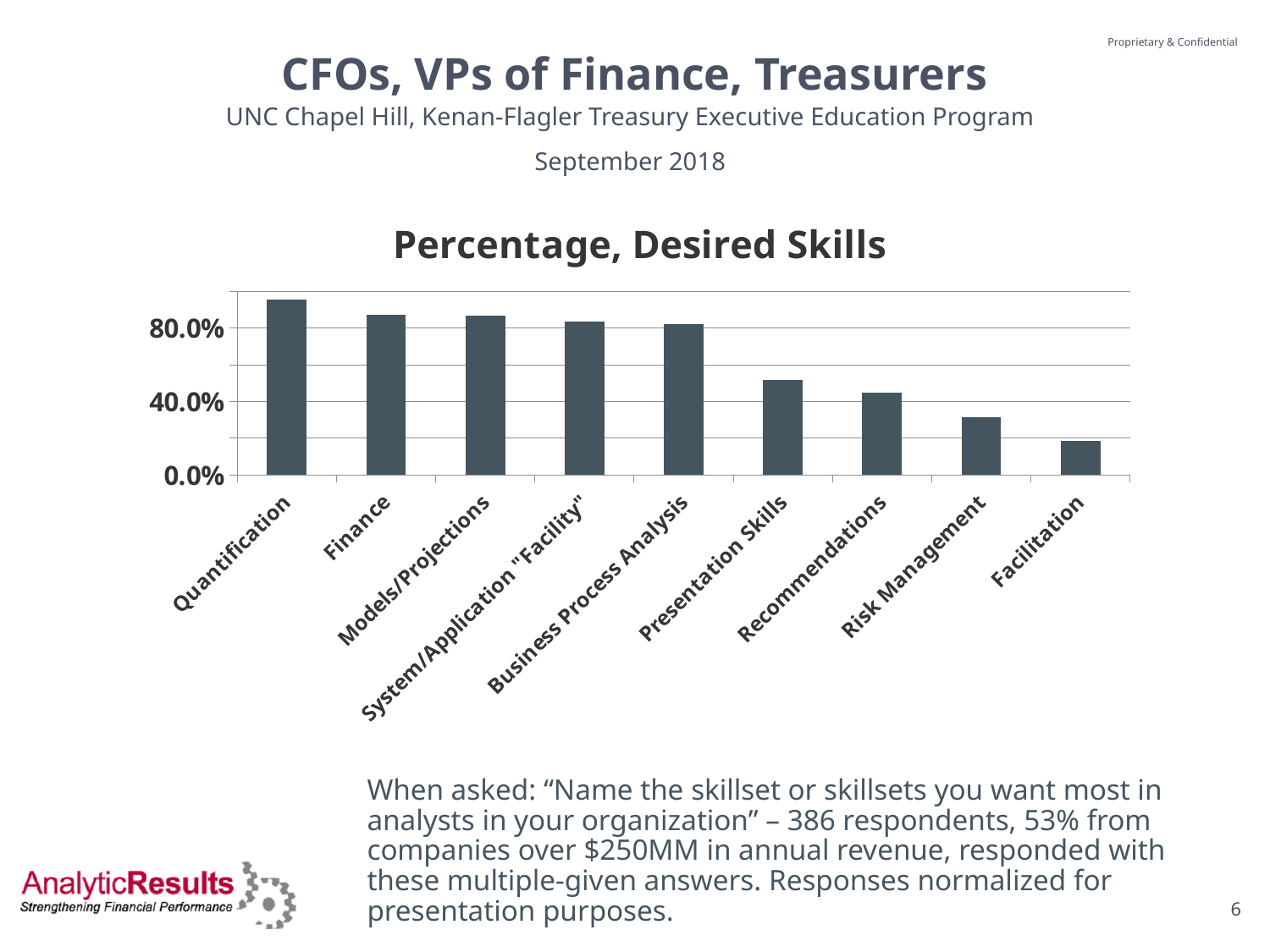
Which skill has the highest percentage in the chart? Quantification Which is larger, the value for Business Process Analysis or the value for Presentation Skills? Business Process Analysis Is the value for Risk Management greater or less than 40.0%? less How many skill categories are plotted in the chart? 9 Do the bar values rise or fall moving from left to right along the x axis? fall Is the value for Presentation Skills greater or less than 40.0%? greater What kind of chart is shown on the slide? bar chart Is the value for Facilitation greater or less than 40.0%? less Which skill has the lowest percentage in the chart? Facilitation Which is larger, the value for Risk Management or the value for Facilitation? Risk Management What is the title of the chart? Percentage, Desired Skills